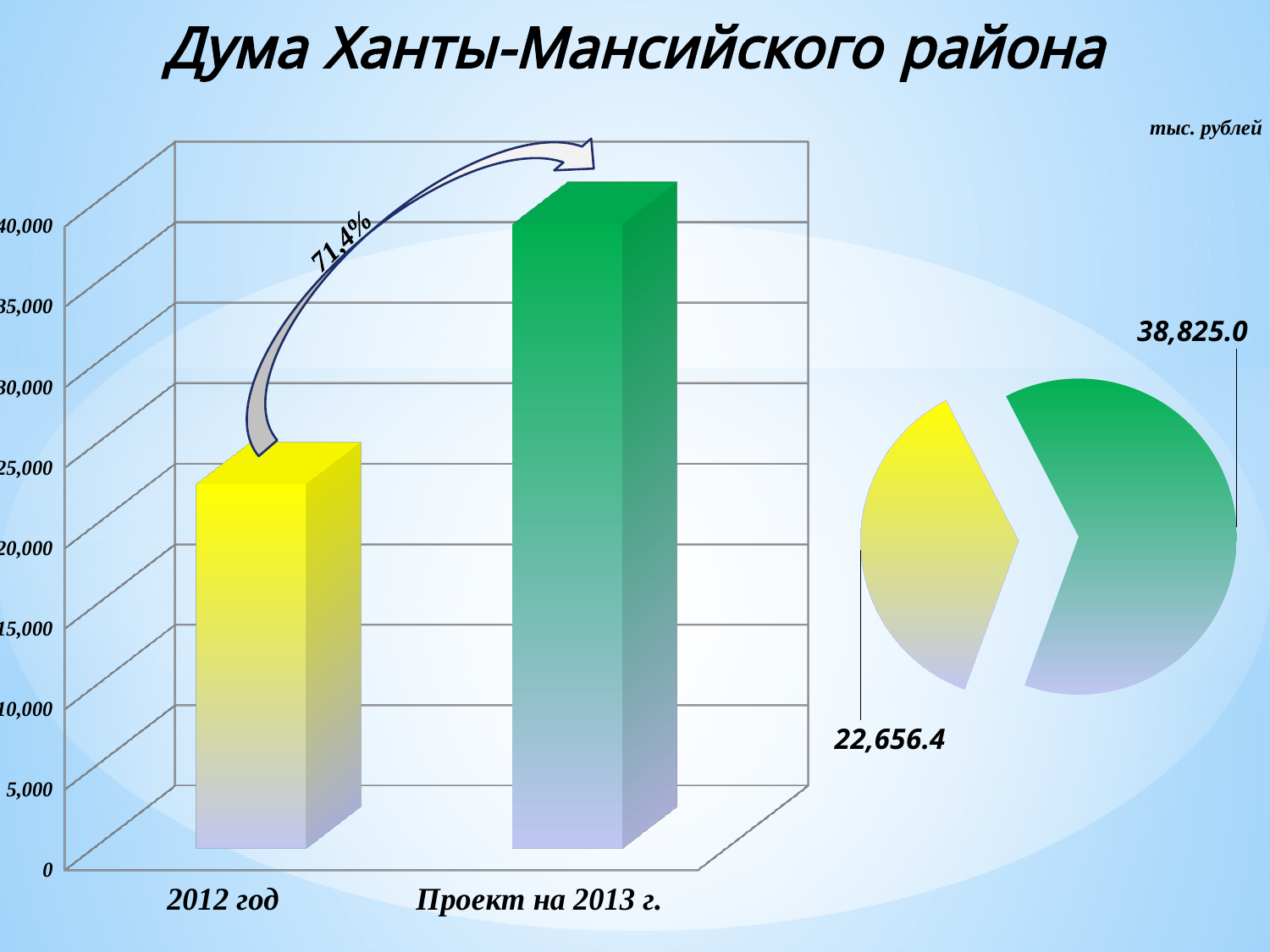
In the bar chart on the left, is the value for 2012 год greater or less than 20,000? greater In the pie chart on the right, what value is labelled on the green slice? 38,825.0 What unit is indicated in the top right corner of the slide? тыс. рублей What kind of chart is the chart on the right of the slide? pie chart What percentage is written on the arrow in the bar chart on the left? 71,4% In the bar chart on the left, which category has the higher bar? Проект на 2013 г. In the pie chart on the right, what value is labelled on the yellow slice? 22,656.4 In the pie chart on the right, what is the difference between the two labelled values? 16,168.6 How many bars does the bar chart on the left show? 2 In the bar chart on the left, is the value for Проект на 2013 г. greater or less than 35,000? greater What kind of chart is the chart on the left of the slide? bar chart In the bar chart on the left, do the values rise or fall from 2012 год to Проект на 2013 г.? rise